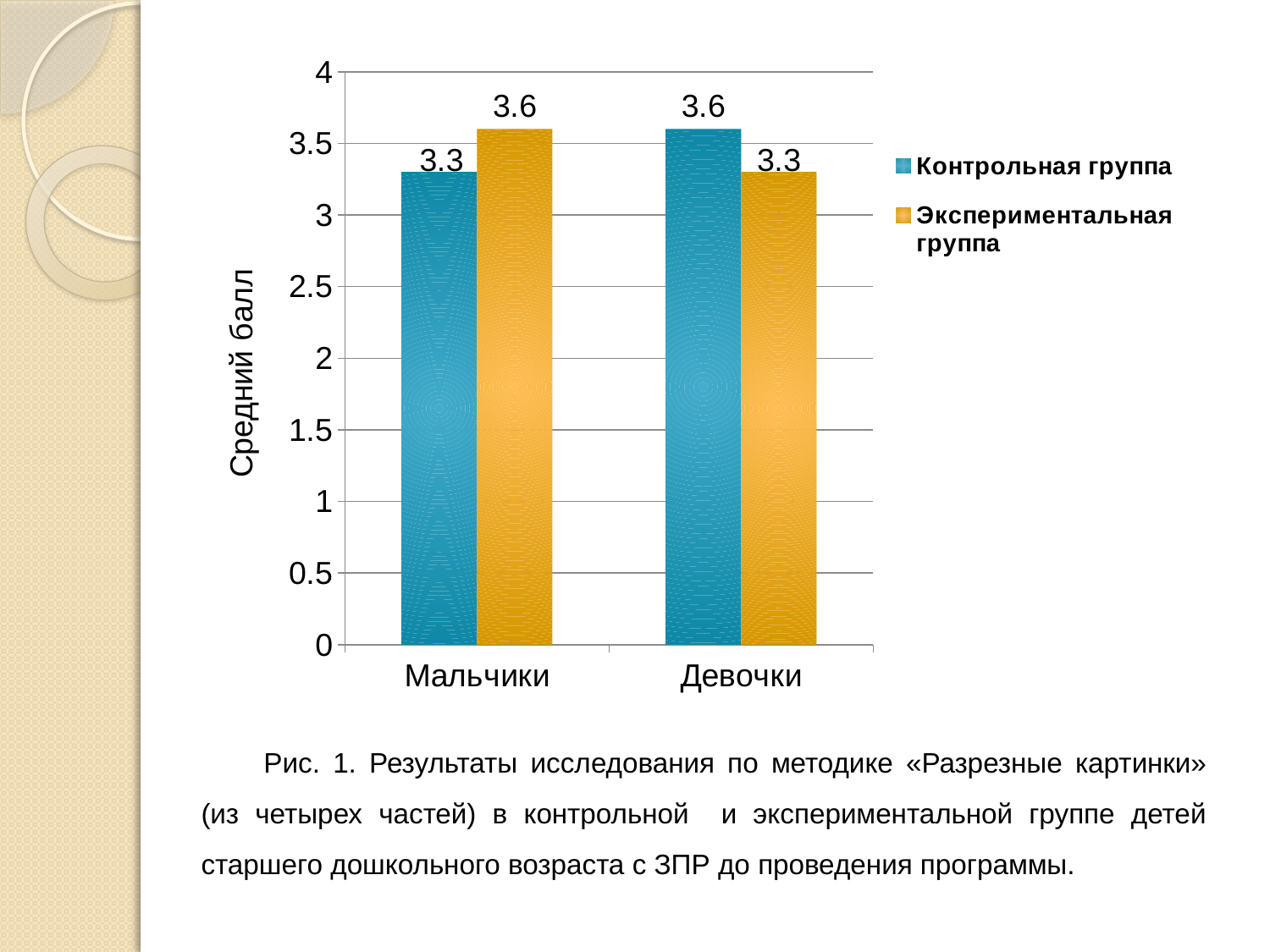
What is the value for Девочки in the Контрольная группа series? 3.6 How many series does the legend list? 2 Which category has the higher value in the Контрольная группа series? Девочки Which category has the lower value in the Экспериментальная группа series? Девочки What is the difference between the Экспериментальная группа and Контрольная группа values for Мальчики? 0.3 Is the value for Мальчики in the Контрольная группа series greater or less than 3? greater What is the value for Мальчики in the Контрольная группа series? 3.3 What is the value for Девочки in the Экспериментальная группа series? 3.3 How many categories are shown on the x axis? 2 For Девочки, which series has the larger value: Контрольная группа or Экспериментальная группа? Контрольная группа What kind of chart is shown on the slide? Bar chart What is the value for Мальчики in the Экспериментальная группа series? 3.6